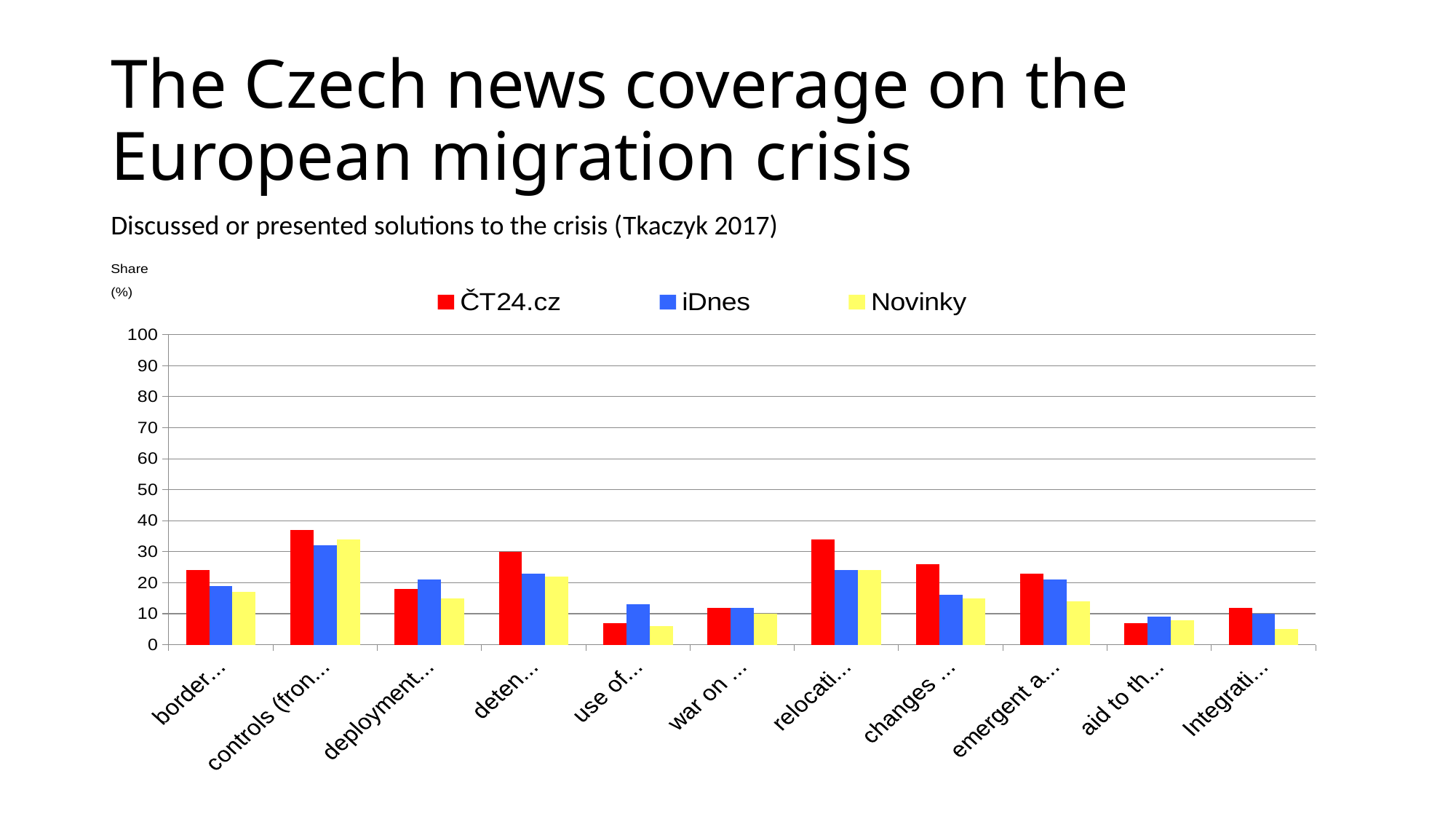
Is the ČT24.cz value for "controls (fron…" greater or less than 30? greater How many categories are shown along the x axis of the chart? 11 Is the Novinky value for "Integrati…" greater or less than 10? less How many series does the chart legend list? 3 Which series is shown in red in the chart? ČT24.cz Is the ČT24.cz value for "border…" greater or less than 20? greater What label is given to the vertical axis of the chart? Share (%) For the category "use of…", which series has the larger value, ČT24.cz or iDnes? iDnes For the category "emergent a…", which series has the larger value, ČT24.cz or Novinky? ČT24.cz What kind of chart is shown on the slide? bar chart For the category "deployment…", which series has the larger value, ČT24.cz or iDnes? iDnes